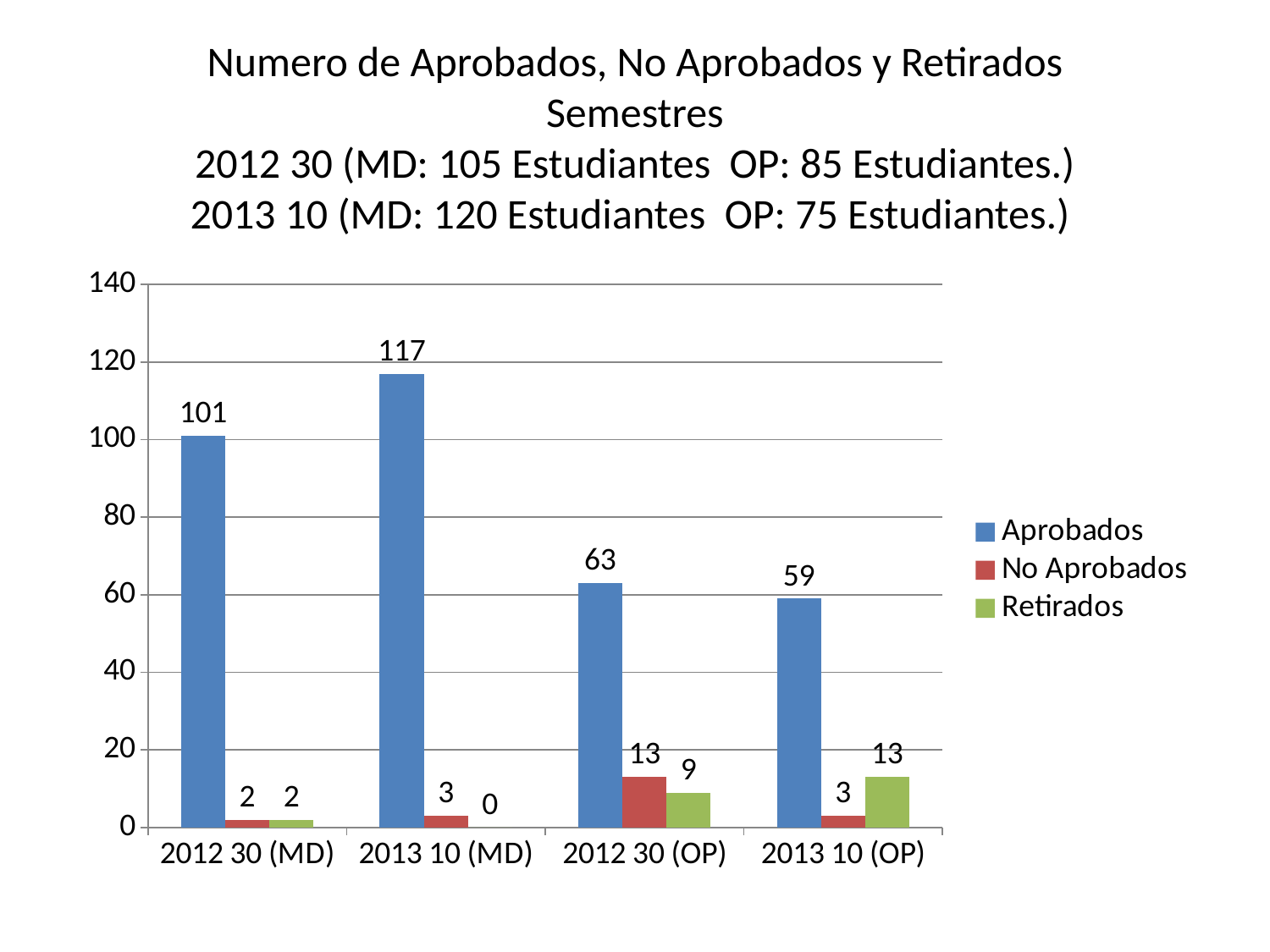
What is the difference between the Aprobados values for 2012 30 (MD) and 2013 10 (MD)? 16 Which is larger, Retirados for 2012 30 (OP) or Retirados for 2013 10 (OP)? 2013 10 (OP) Which category has the highest Aprobados value? 2013 10 (MD) What is the value of Retirados for 2013 10 (MD)? 0 What is the value of Aprobados for 2013 10 (MD)? 117 What kind of chart is shown on the slide? bar chart How many series does the legend list? 3 Is the Aprobados value for 2012 30 (OP) greater or less than 80? less How many categories are shown on the x axis? 4 What is the value of No Aprobados for 2012 30 (OP)? 13 What colour represents the Retirados series? green Which category has the lowest Aprobados value? 2013 10 (OP)